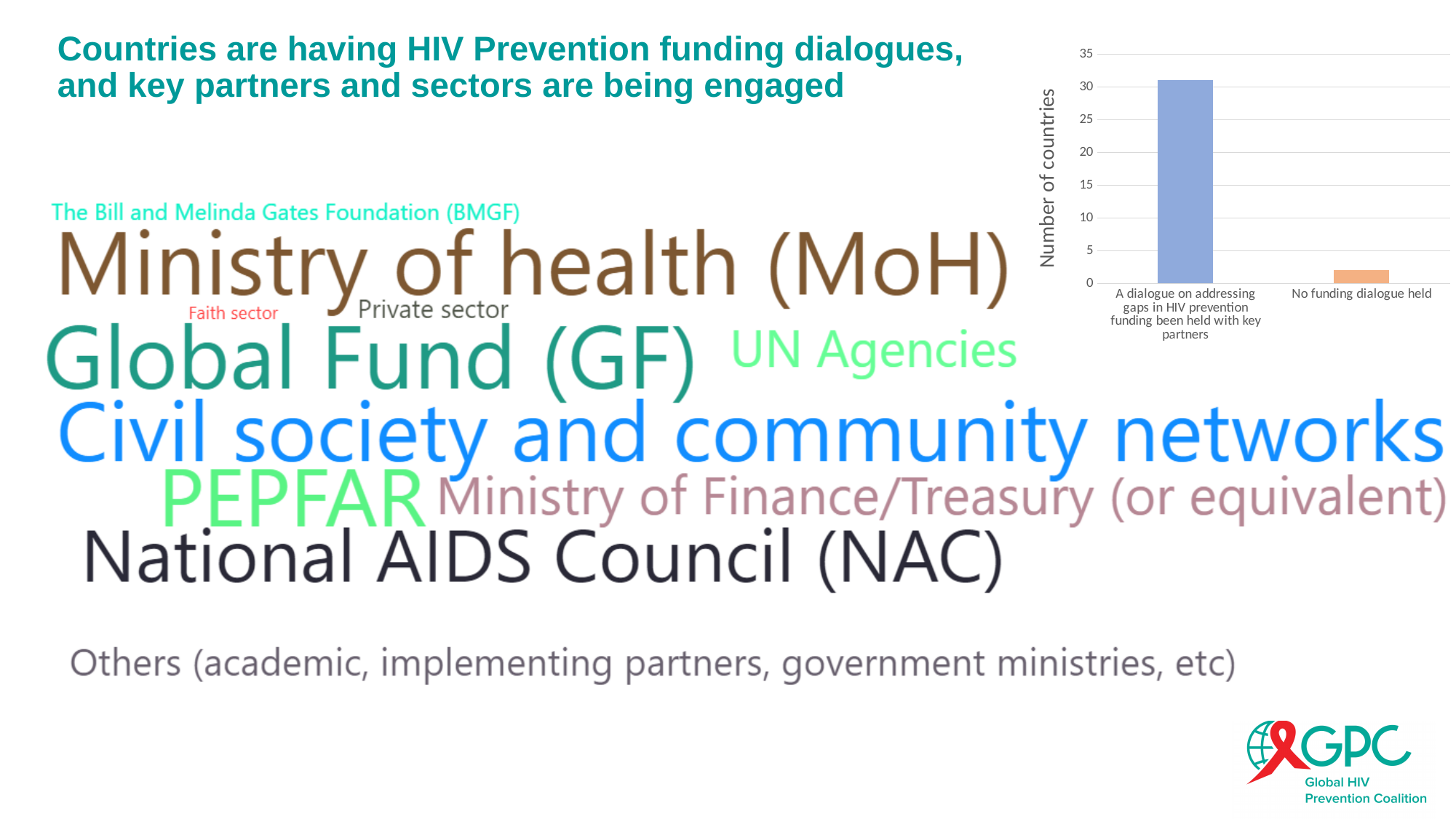
In the bar chart, is the number of countries where a dialogue on addressing gaps in HIV prevention funding has been held with key partners greater or less than 25? greater What is the label of the vertical axis of the bar chart? Number of countries What kind of chart is shown on the right side of the slide? bar chart Which category in the bar chart has the highest number of countries? A dialogue on addressing gaps in HIV prevention funding been held with key partners Which category in the bar chart has the lowest number of countries? No funding dialogue held In the bar chart, is the number of countries with no funding dialogue held greater or less than 10? less How many categories does the bar chart on the right show? 2 What is the highest value shown on the vertical axis of the bar chart? 35 In the bar chart, is the number of countries with no funding dialogue held greater or less than 5? less In the bar chart, which is larger: the number of countries where a dialogue on addressing gaps in HIV prevention funding has been held with key partners, or the number where no funding dialogue was held? A dialogue on addressing gaps in HIV prevention funding been held with key partners